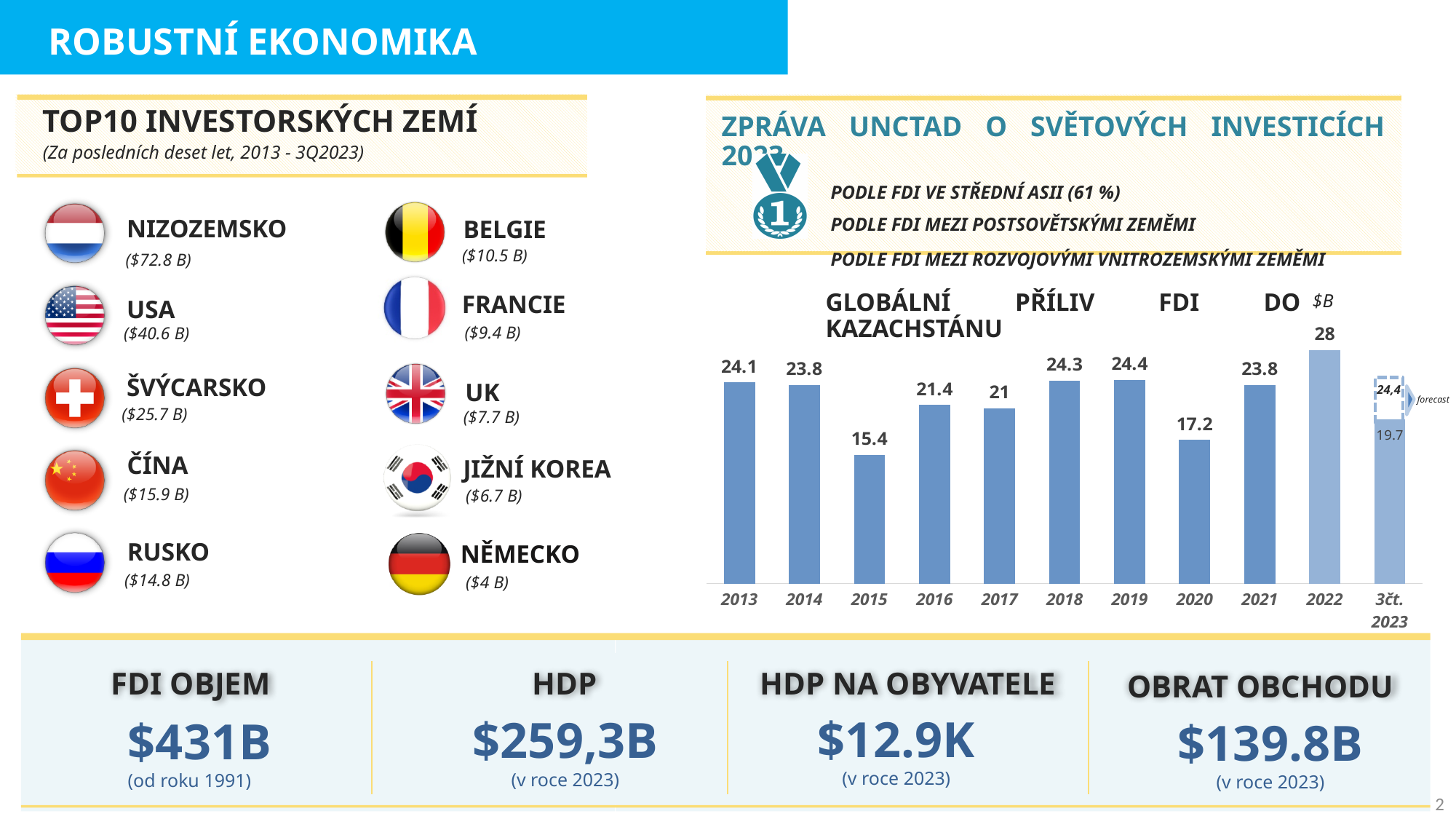
How many bars are shown in the FDI inflow chart? 11 Which year has the highest FDI inflow to Kazakhstan in the chart? 2022 Which year has the lowest FDI inflow to Kazakhstan in the chart? 2015 What is the forecast value shown for 3čt. 2023 in the FDI inflow chart? 24,4 What unit is indicated next to the title of the FDI inflow chart? $B What kind of chart is used to show the global FDI inflow to Kazakhstan? bar chart What is the FDI inflow to Kazakhstan in 2020? 17.2 What is the FDI inflow to Kazakhstan in 2022? 28 What is the FDI inflow to Kazakhstan in 2019? 24.4 What is the FDI inflow to Kazakhstan in 2015? 15.4 What is the difference between the FDI inflow in 2022 and in 2020? 10.8 Which is larger, the FDI inflow in 2018 or in 2017? 2018